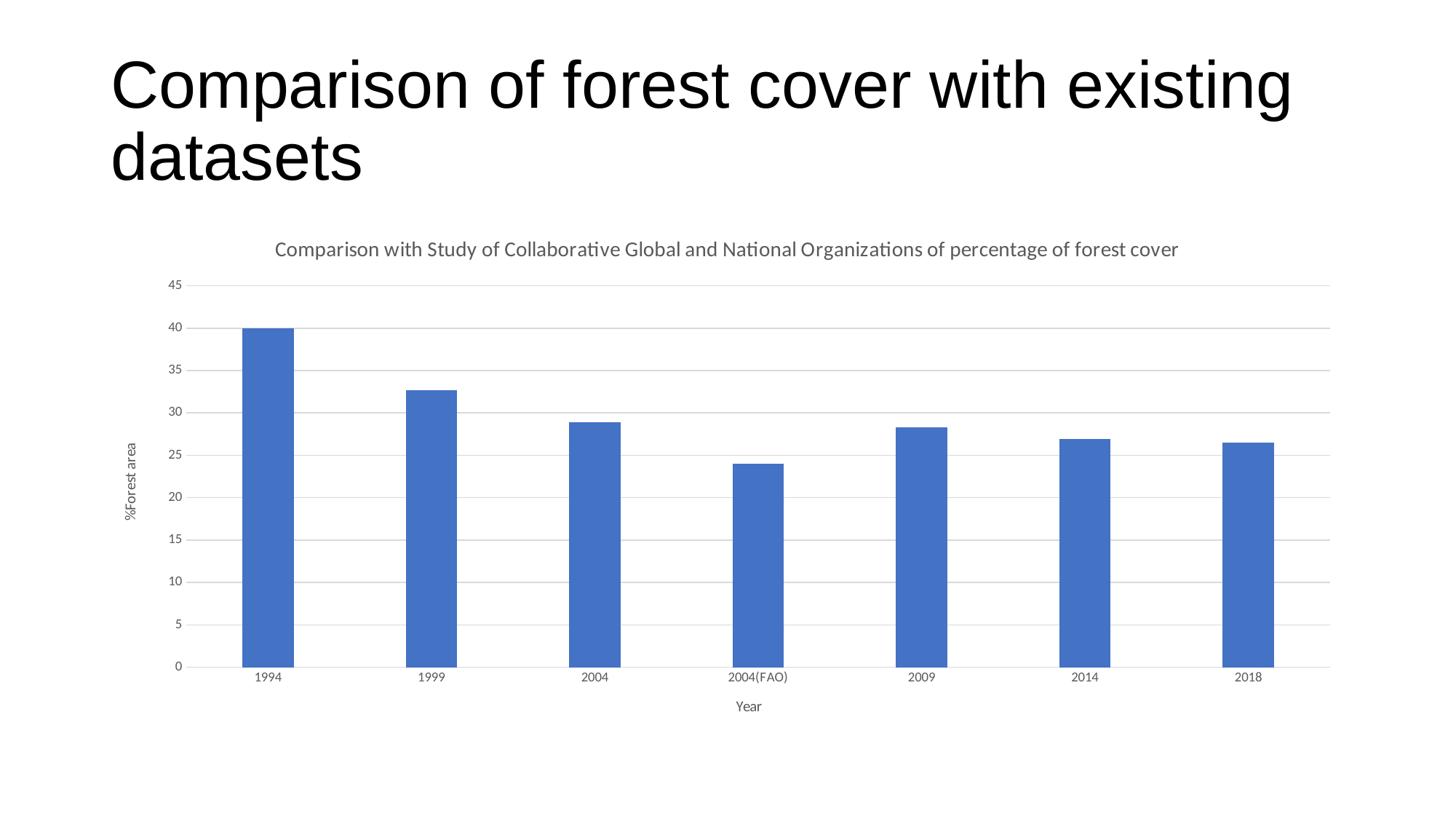
Is the value for 2004(FAO) greater or less than 25? less What is the label on the vertical axis of the chart? %Forest area What is the label on the horizontal axis of the chart? Year Which is larger, the value for 1999 or the value for 2004? 1999 How many bars (categories) are plotted in the chart? 7 Is the value for 1999 greater or less than 30? greater Which is larger, the value for 2004(FAO) or the value for 2009? 2009 What kind of chart is shown on the slide? bar chart Is the value for 2018 greater or less than 25? greater Which year has the highest percentage of forest area? 1994 Which category has the lowest percentage of forest area? 2004(FAO)